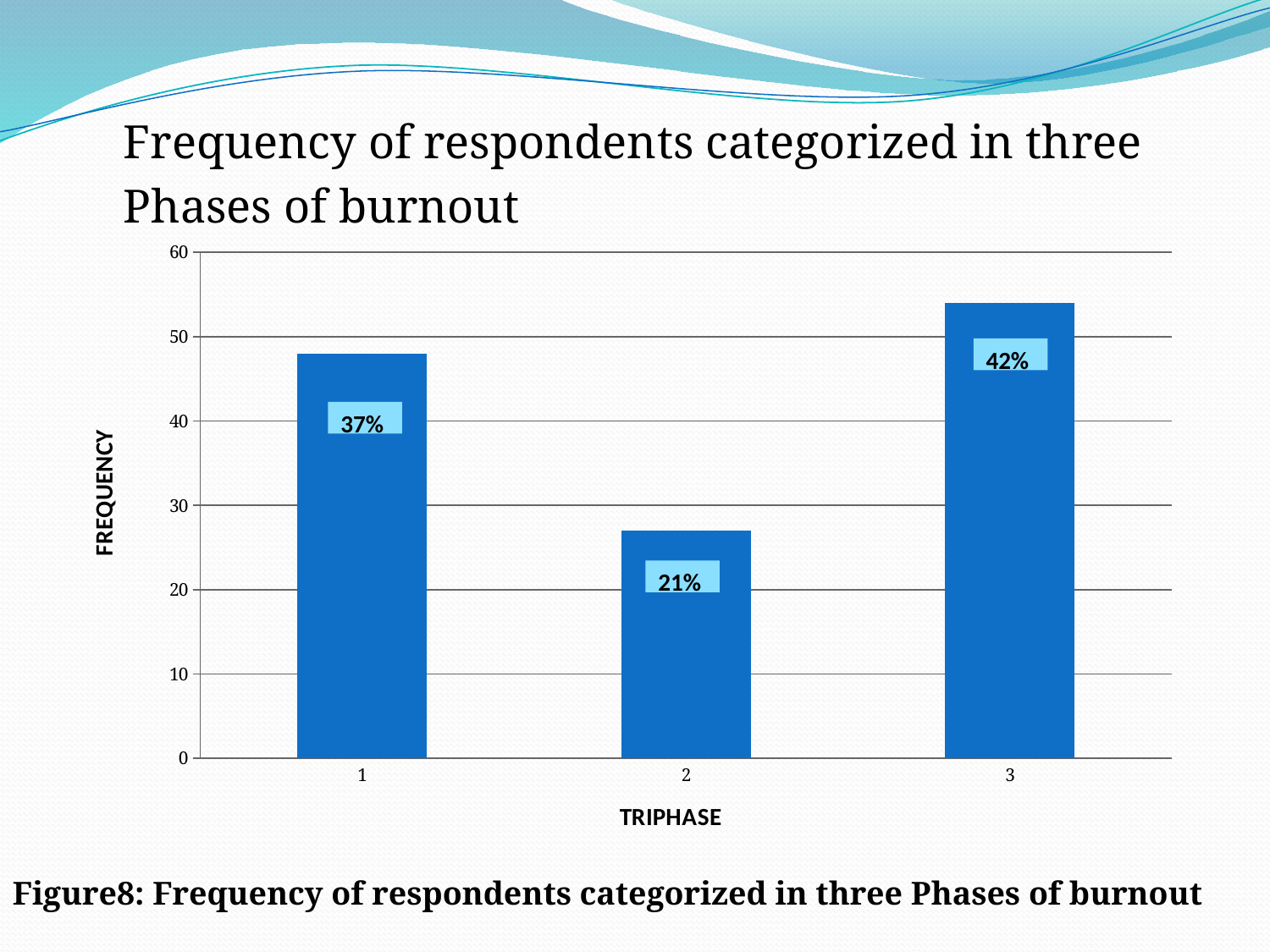
What percentage label is shown on the bar for triphase 2? 21% Is the frequency for triphase 2 greater or less than 30? less What percentage label is shown on the bar for triphase 3? 42% Which triphase category has the lowest frequency? 2 How many triphase categories are plotted on the chart? 3 Which triphase category has the highest frequency? 3 What type of chart is shown on the slide? Bar chart What is the label of the vertical axis? FREQUENCY What is the difference in percentage points between the labels for triphase 3 and triphase 2? 21% Which has a higher frequency, triphase 1 or triphase 2? Triphase 1 What percentage label is shown on the bar for triphase 1? 37% Is the frequency for triphase 3 greater or less than 50? greater